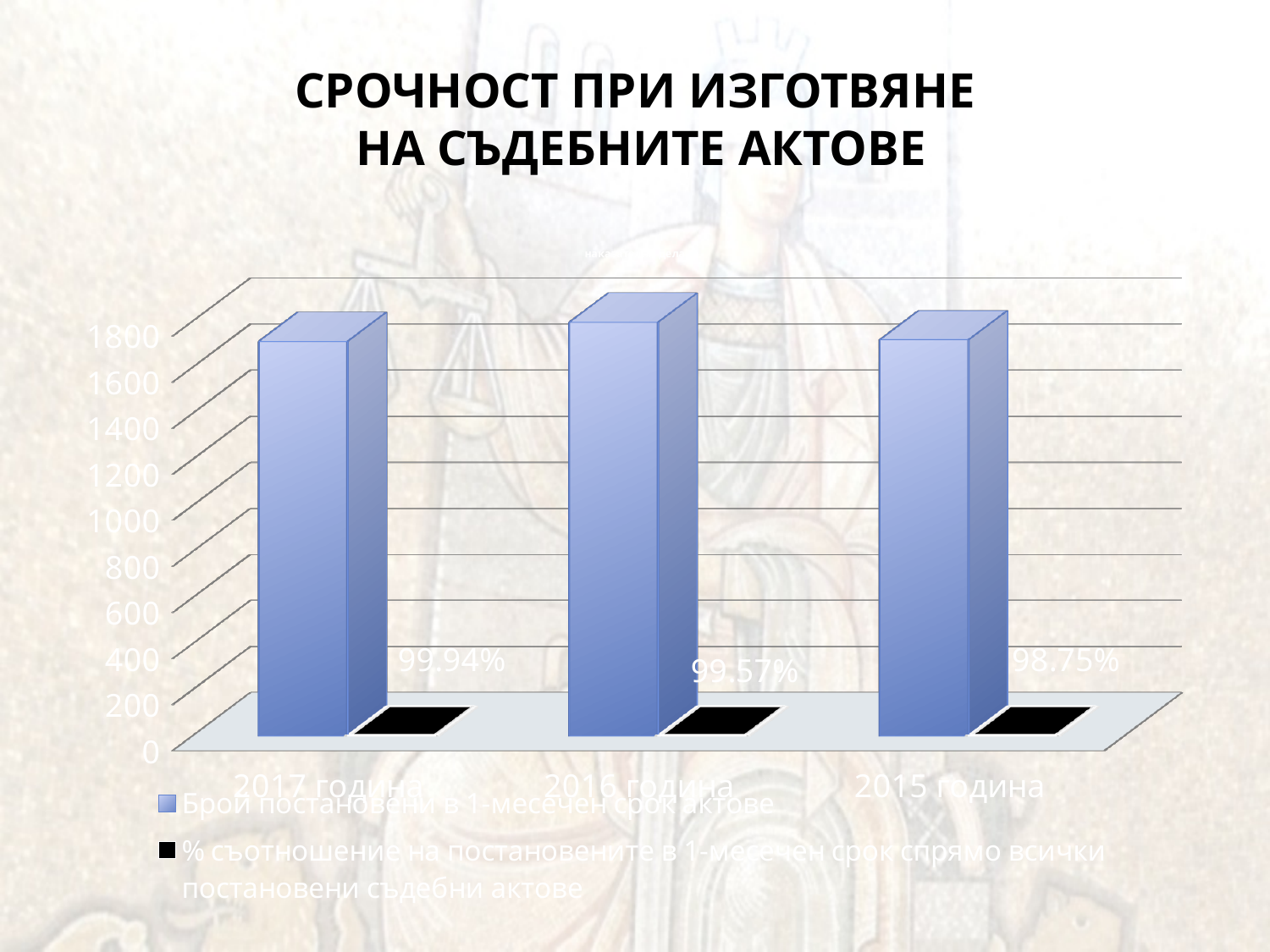
What is the difference in percentage points between the 2017 година and 2015 година percentage values? 1.19 What is the percentage of acts issued within the 1-month period for 2017 година? 99.94% What type of chart is shown on the slide? Bar chart What is the title of the slide? СРОЧНОСТ ПРИ ИЗГОТВЯНЕ НА СЪДЕБНИТЕ АКТОВЕ Which year has the highest percentage of acts issued within the 1-month period? 2017 година Which year has the tallest bar for the number of acts issued within the 1-month period? 2016 година What is the percentage of acts issued within the 1-month period for 2015 година? 98.75% Is the number of acts issued within the 1-month period for 2016 година greater or less than 1400? greater How many series does the legend list? 2 How many year categories are shown on the x axis? 3 What is the percentage of acts issued within the 1-month period for 2016 година? 99.57% Which year has the lowest percentage of acts issued within the 1-month period? 2015 година